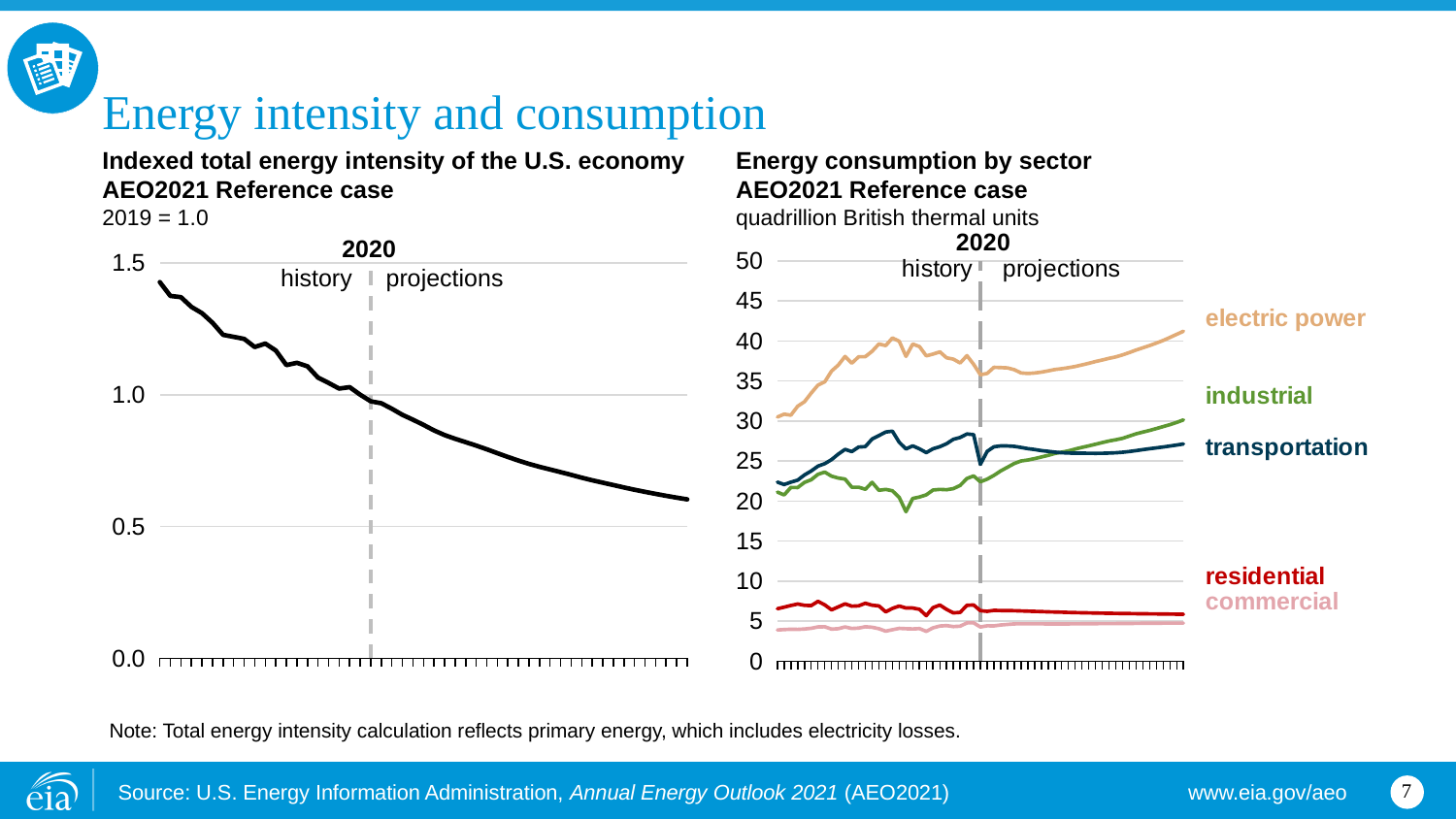
In the 'Energy consumption by sector' chart, which sector has the lowest consumption at the end of the projection period? commercial In the 'Energy consumption by sector' chart, which sector has the highest consumption at the end of the projection period? electric power What unit is used on the 'Energy consumption by sector' chart? quadrillion British thermal units In the 'Energy consumption by sector' chart, does electric power consumption rise or fall over the projection period? rise In the 'Energy consumption by sector' chart, how many sectors are plotted as separate lines? 5 What kind of chart is the 'Energy consumption by sector' chart on the right? line chart In the 'Indexed total energy intensity of the U.S. economy' chart, is the value at the end of the projections greater or less than 0.5? greater In the 'Energy consumption by sector' chart, is the electric power value at the end of the projections greater or less than 35? greater In the 'Energy consumption by sector' chart, is the industrial value at the end of the projections greater or less than 25? greater In the 'Indexed total energy intensity of the U.S. economy' chart, does the line rise or fall over time? fall In the 'Energy consumption by sector' chart, which is larger at the end of the projections: residential or commercial? residential In the 'Energy consumption by sector' chart, which is larger at the end of the projections: industrial or transportation? industrial